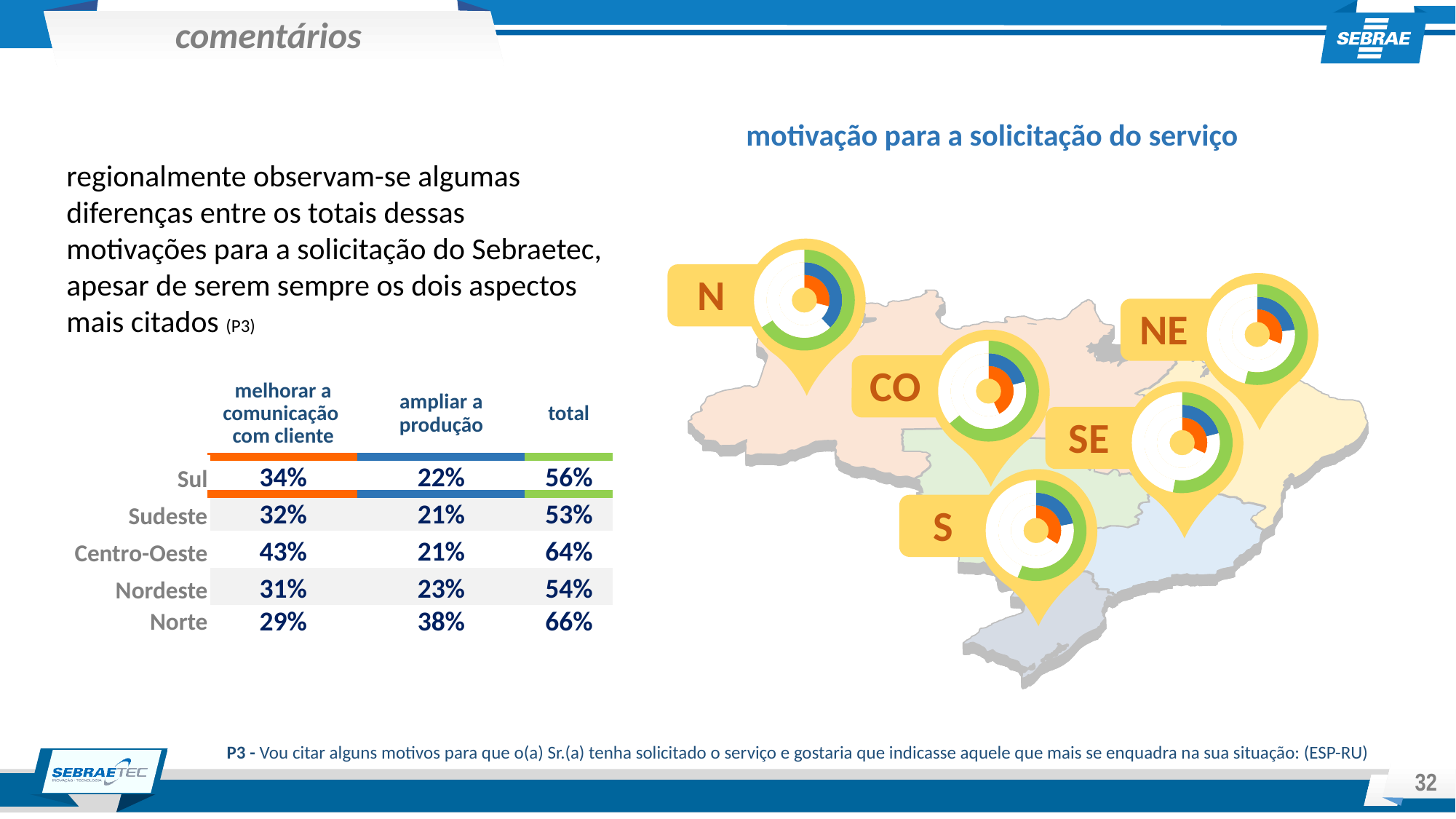
In the table, which is larger for "melhorar a comunicação com cliente": Sul or Nordeste? Sul In the table, what is the value for Centro-Oeste under "melhorar a comunicação com cliente"? 43% In the table, which region has the lowest value for "melhorar a comunicação com cliente"? Norte In the table, which region has the highest total? Norte In the table header, which colour bar marks the "ampliar a produção" column? Blue What is the title shown above the map with the regional charts? motivação para a solicitação do serviço In the table, which region has the highest value for "ampliar a produção"? Norte In the table, what is the value for Norte under "ampliar a produção"? 38% How many value columns does the table have? 3 In the table, which region has the lowest total? Sudeste How many regions are listed in the table? 5 In the table, what is the difference between the total for Sul and the total for Sudeste? 3%